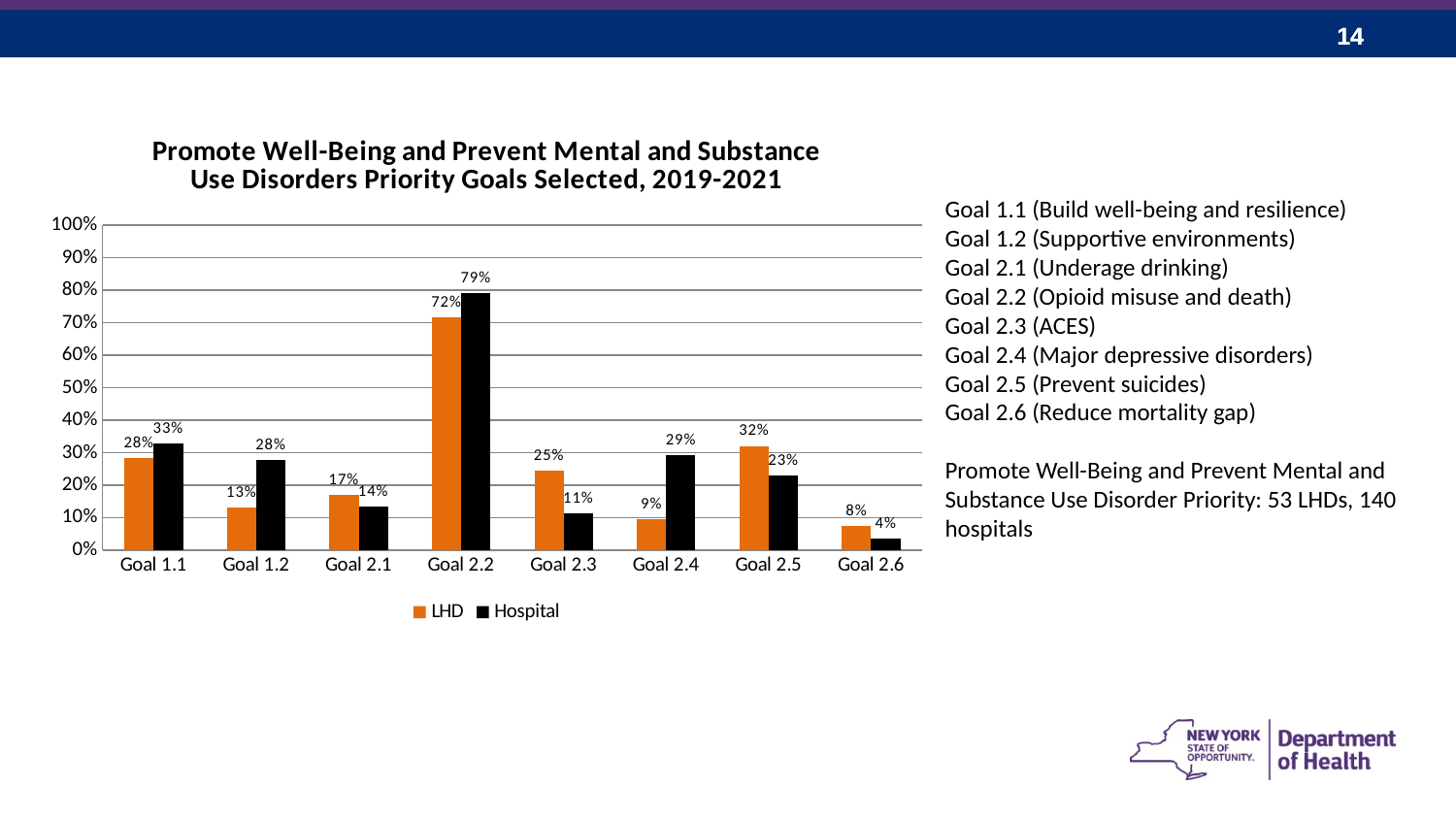
How many goals are shown on the x axis? 8 For Goal 2.5, which is larger, the LHD value or the Hospital value? LHD What is the difference between the Hospital and LHD values for Goal 2.2? 7% What is the LHD value for Goal 2.2? 72% What kind of chart is shown? Bar chart How many series does the legend list? 2 Which goal has the highest Hospital value? Goal 2.2 What is the title of the chart? Promote Well-Being and Prevent Mental and Substance Use Disorders Priority Goals Selected, 2019-2021 What is the LHD value for Goal 2.6? 8% Which goal has the lowest LHD value? Goal 2.6 What is the difference between the LHD and Hospital values for Goal 2.3? 14% What is the Hospital value for Goal 2.4? 29%